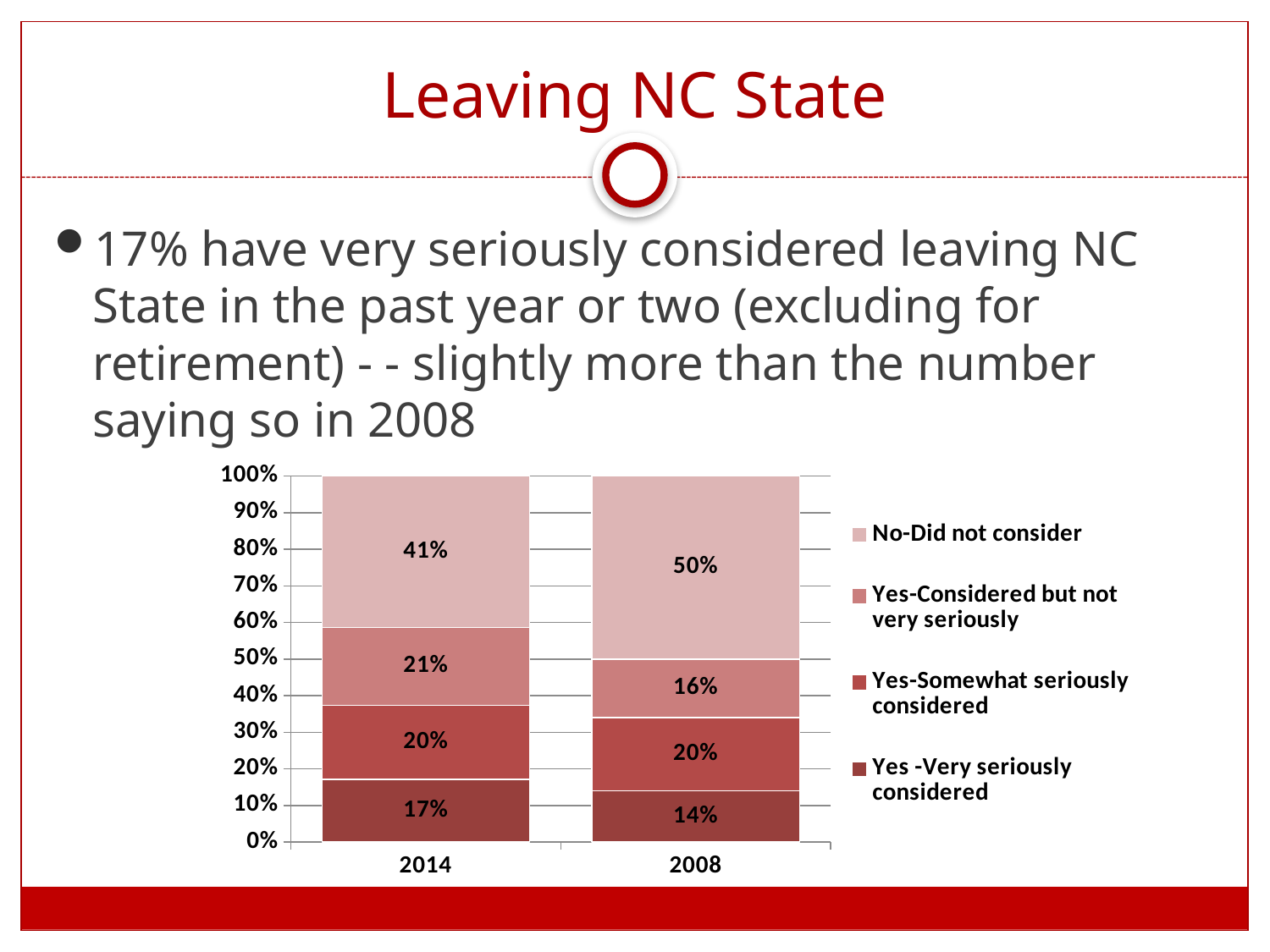
What percentage of respondents in 2008 did not consider leaving NC State? 50% What is the value for 'Yes-Considered but not very seriously' in 2014? 21% Which year has the larger share of respondents who very seriously considered leaving, 2014 or 2008? 2014 What is the difference between the 'Yes-Considered but not very seriously' values for 2014 and 2008? 5% What is the value for 'Yes-Somewhat seriously considered' in 2008? 20% What percentage of respondents in 2014 said they very seriously considered leaving NC State? 17% What is the difference between the 'No-Did not consider' values for 2008 and 2014? 9% How many series does the legend list? 4 Which segment is the smallest in the 2008 bar? Yes -Very seriously considered How many years are shown on the x axis? 2 Which segment is the largest in the 2014 bar? No-Did not consider What kind of chart is shown on the slide? Stacked bar chart